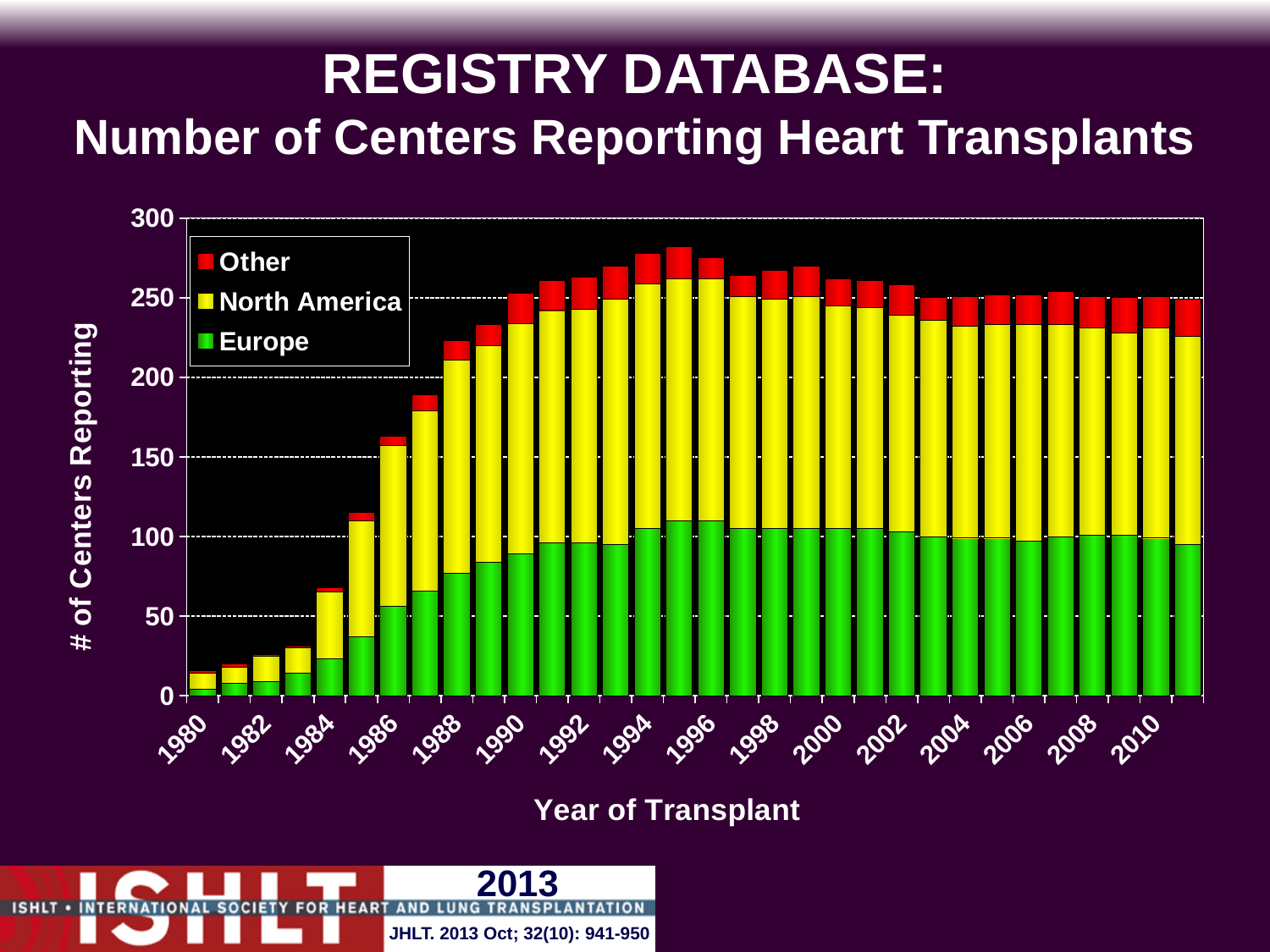
Is the total number of centers reporting in 1980 greater or less than 50? less Which series are listed in the legend? Other, North America, Europe Which year has the highest total number of centers reporting? 1995 Does the total number of centers reporting rise or fall from 1980 to 1995? rise Is the total number of centers reporting in 1995 greater or less than 250? greater Is the number of Europe centers reporting in 1984 greater or less than 50? less What is the title of the y axis? # of Centers Reporting Which year has the lowest total number of centers reporting? 1980 How many series does the legend list? 3 What kind of chart is shown on the slide? stacked bar chart